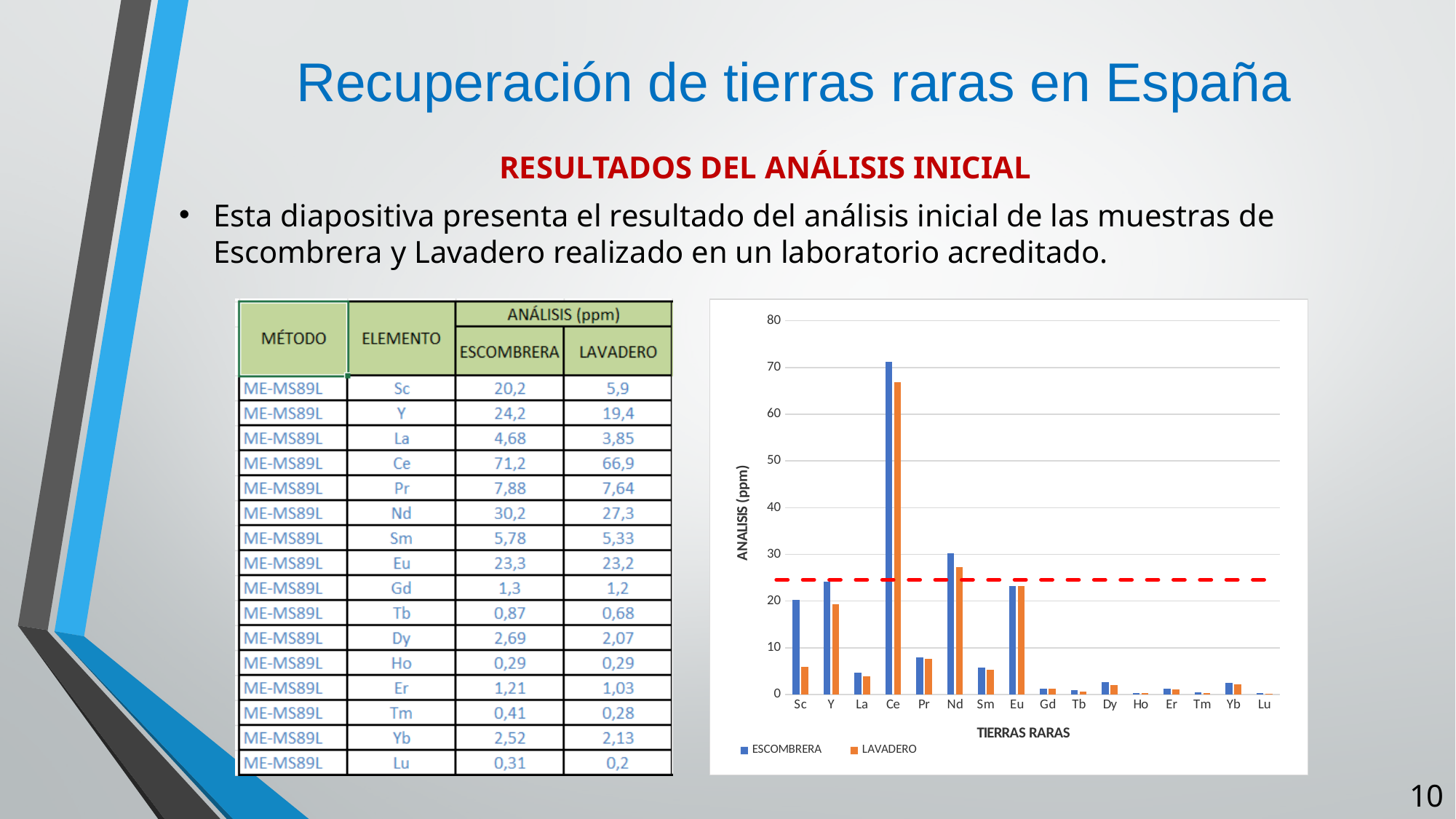
According to the table, what is the difference between the ESCOMBRERA and LAVADERO values for Sc? 14,3 What type of chart is shown on the slide? bar chart How many rare earth elements are shown on the x axis of the chart? 16 Is the ESCOMBRERA value for Ce greater or less than 60? greater Which element has the highest ESCOMBRERA value in the chart? Ce How many series does the chart legend list? 2 According to the table, what is the LAVADERO value for Ce in ppm? 66,9 What is the title of the chart's vertical axis? ANALISIS (ppm) Is the LAVADERO value for Sc greater or less than 10? less For Sc, which series has the larger value, ESCOMBRERA or LAVADERO? ESCOMBRERA Which has the larger ESCOMBRERA value, Y or Nd? Nd Is the ESCOMBRERA value for Nd greater or less than 20? greater